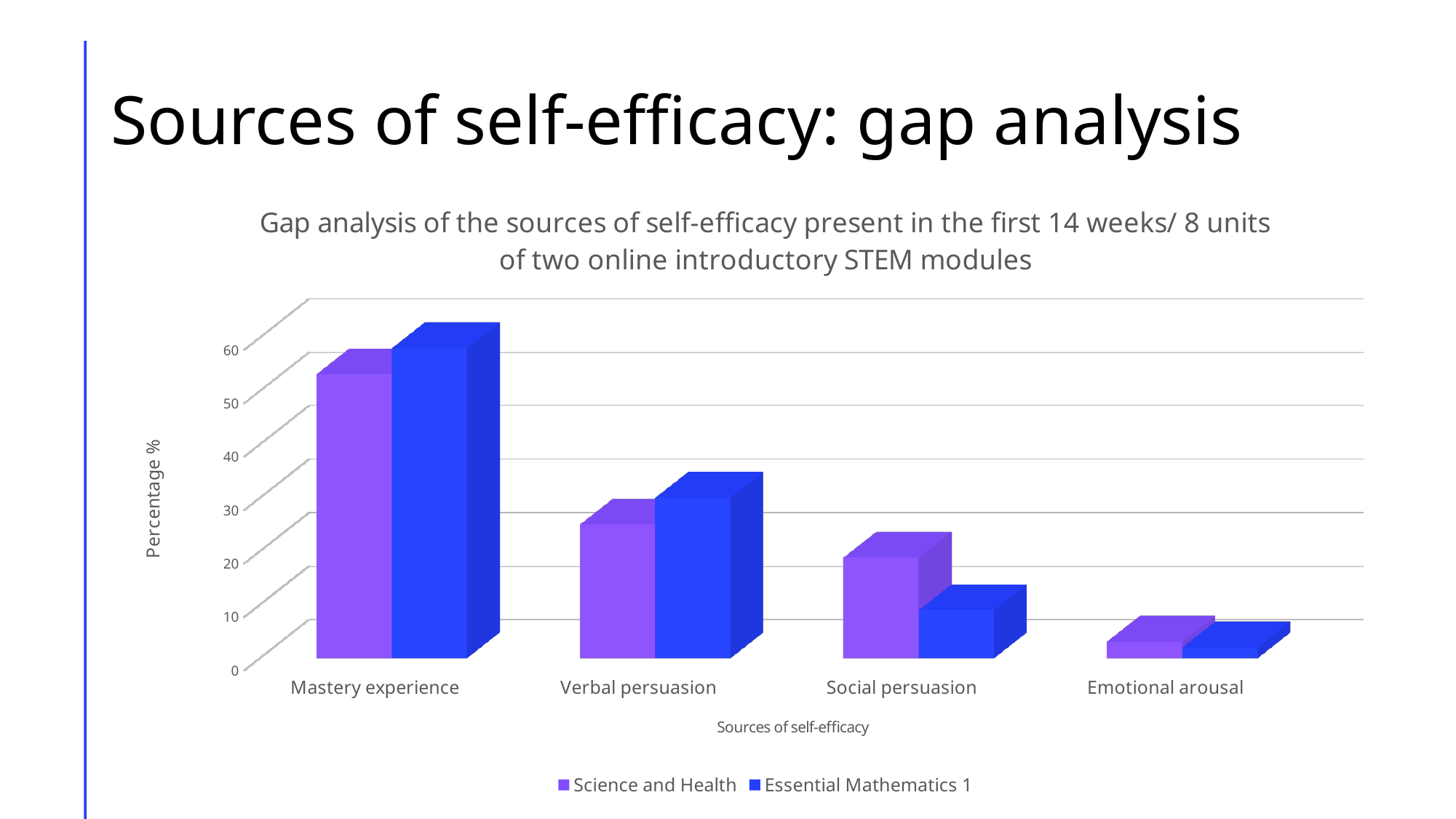
How many series does the legend list? 2 Which source of self-efficacy has the highest value for Science and Health? Mastery experience Do the values for Essential Mathematics 1 rise or fall moving from left to right along the x axis? fall Is the value for Emotional arousal in the Science and Health series greater or less than 10? less For Mastery experience, which series has the larger value, Science and Health or Essential Mathematics 1? Essential Mathematics 1 Is the value for Mastery experience in the Science and Health series greater or less than 40? greater Is the value for Social persuasion in the Essential Mathematics 1 series greater or less than 20? less How many sources of self-efficacy are shown on the x axis? 4 What is the title of the vertical axis? Percentage % What kind of chart is shown on the slide? bar chart Which source of self-efficacy has the lowest value for Essential Mathematics 1? Emotional arousal For Social persuasion, which series has the larger value, Science and Health or Essential Mathematics 1? Science and Health